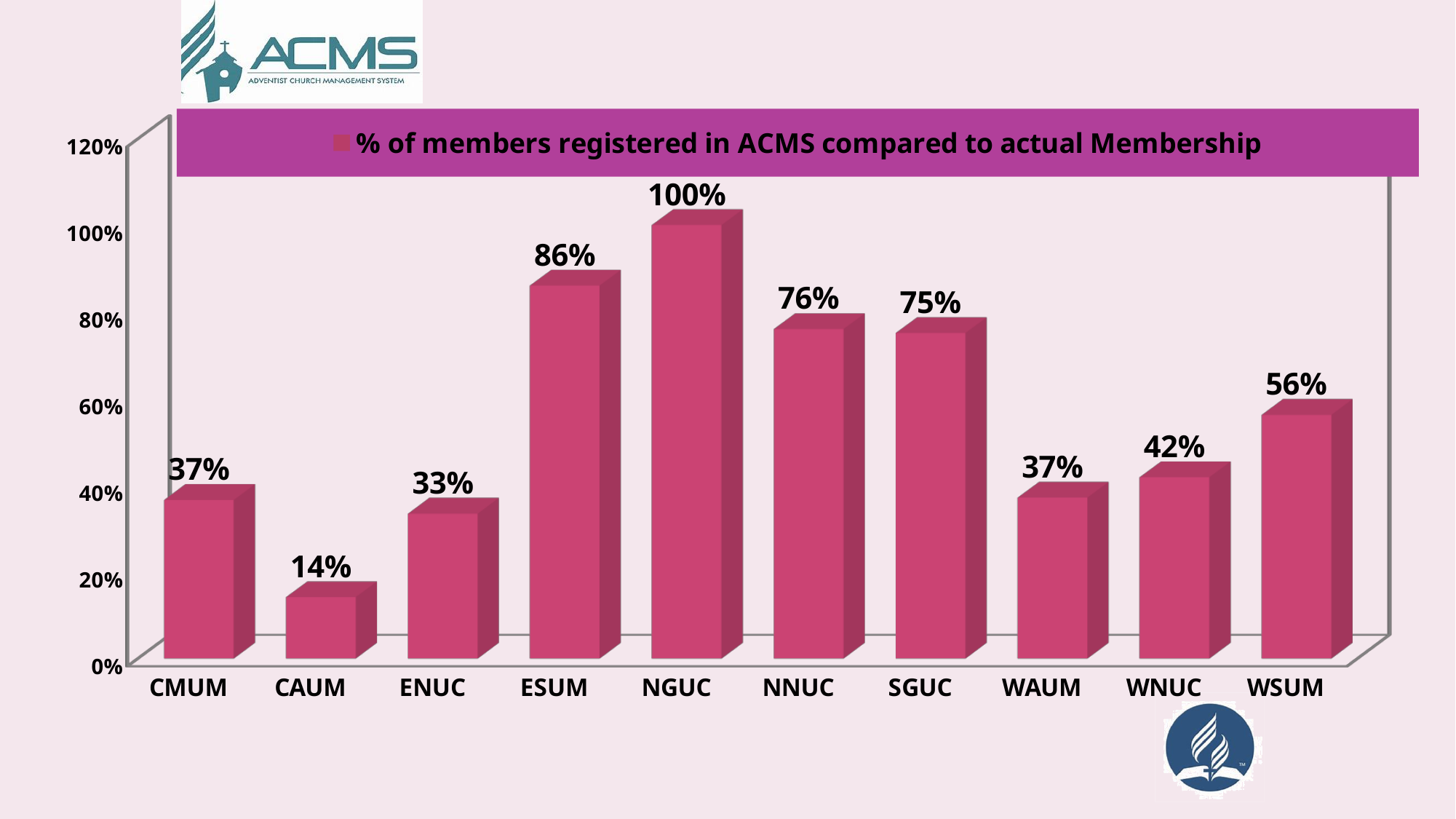
How many categories are shown on the x axis? 10 Is the value for SGUC greater or less than 60%? greater Which category has the highest value? NGUC What is the value for WSUM? 56% What is the legend entry for the series? % of members registered in ACMS compared to actual Membership Which category has the lowest value? CAUM What kind of chart is this? bar chart How many series does the legend list? 1 What is the value for NGUC? 100% What is the value for CAUM? 14% What is the difference between the values for ESUM and ENUC? 53% Which is larger, the value for NNUC or the value for WNUC? NNUC